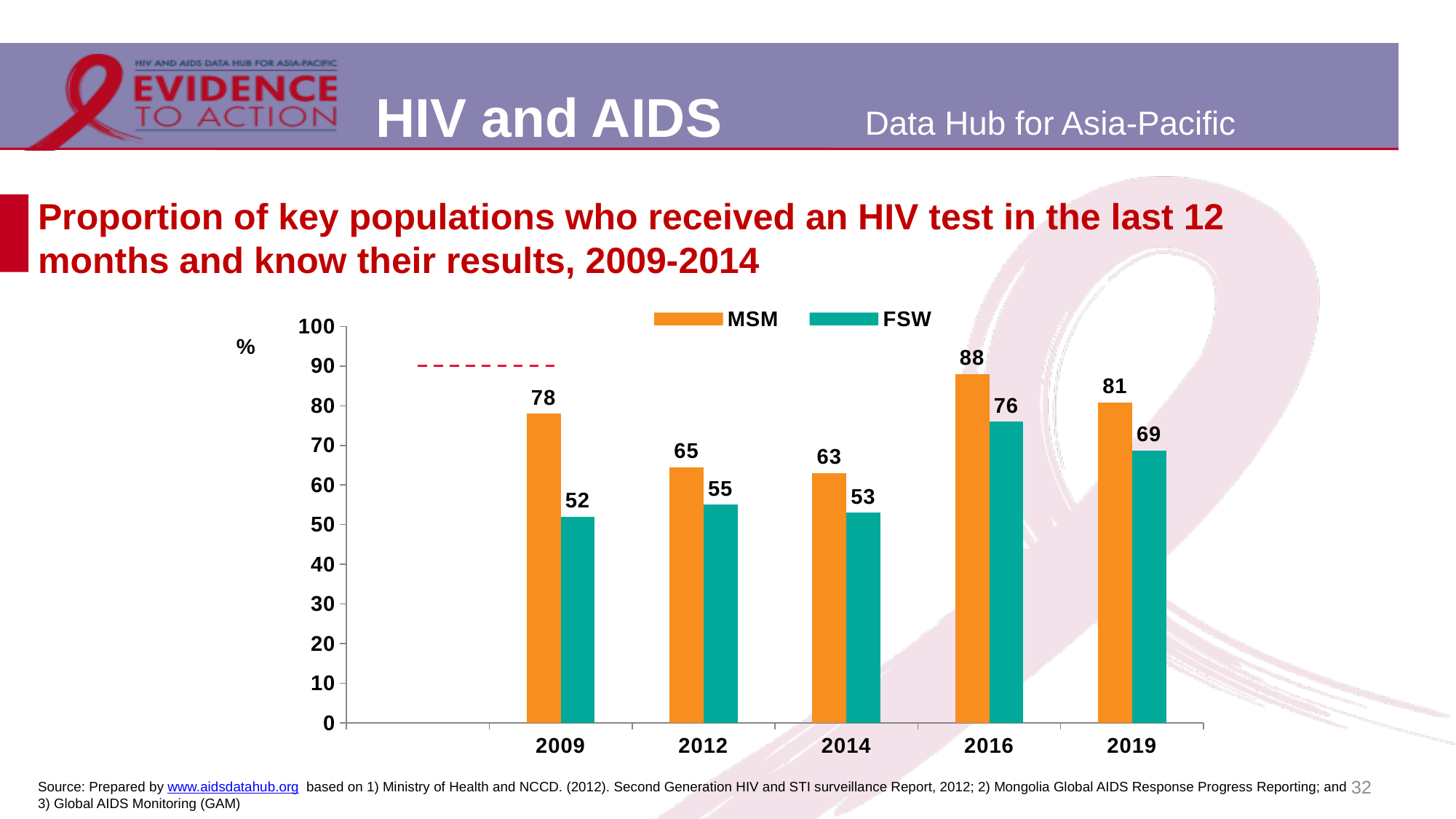
How many series does the legend list? 2 What is the difference between the MSM and FSW values in 2009? 26 How many years are shown on the x axis? 5 What kind of chart is shown on the slide? bar chart Is the value for FSW in 2016 greater or less than 70? greater What is the value for MSM in 2019? 81 What is the value for MSM in 2016? 88 In which year is the FSW value lowest? 2009 Which colour represents FSW in the chart? teal Which is larger in 2014, the MSM value or the FSW value? MSM What is the value for FSW in 2009? 52 In which year is the MSM value highest? 2016